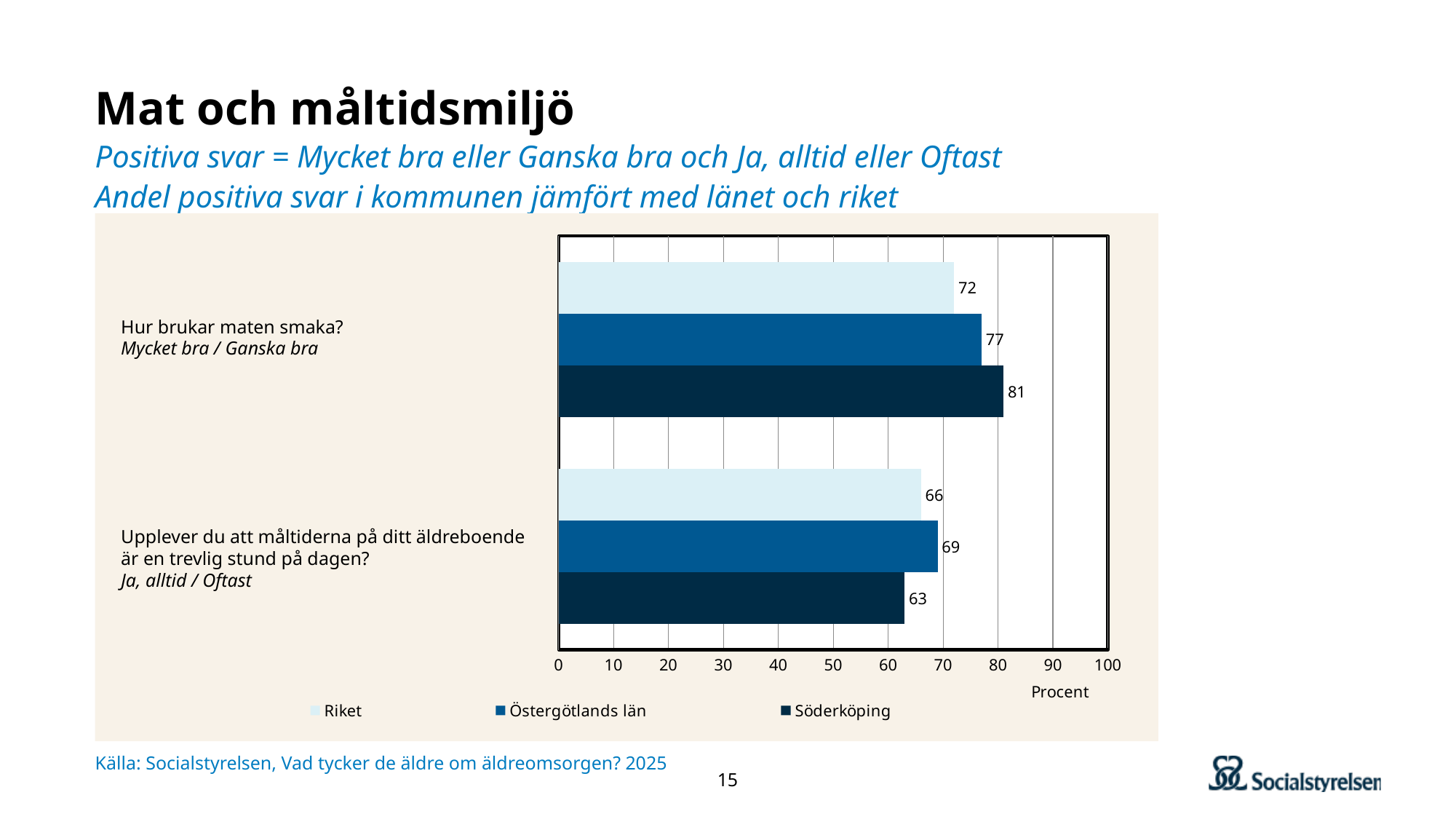
Which series has the lowest value for "Upplever du att måltiderna på ditt äldreboende är en trevlig stund på dagen?"? Söderköping What is the value for Söderköping on the question "Hur brukar maten smaka?"? 81 Is the value for Riket on "Hur brukar maten smaka?" greater or less than 70? greater What is the difference between Söderköping and Riket on "Hur brukar maten smaka?"? 9 What is the value for Östergötlands län on the question "Hur brukar maten smaka?"? 77 What kind of chart is shown on the slide? Bar chart Which is larger: Söderköping's value for "Hur brukar maten smaka?" or Söderköping's value for "Upplever du att måltiderna på ditt äldreboende är en trevlig stund på dagen?"? Hur brukar maten smaka? What unit is shown on the horizontal axis of the chart? Procent What is the value for Riket on the question "Upplever du att måltiderna på ditt äldreboende är en trevlig stund på dagen?"? 66 What is the difference between Östergötlands län and Söderköping on "Upplever du att måltiderna på ditt äldreboende är en trevlig stund på dagen?"? 6 How many series does the legend list? 3 Which series has the highest value for "Hur brukar maten smaka?"? Söderköping